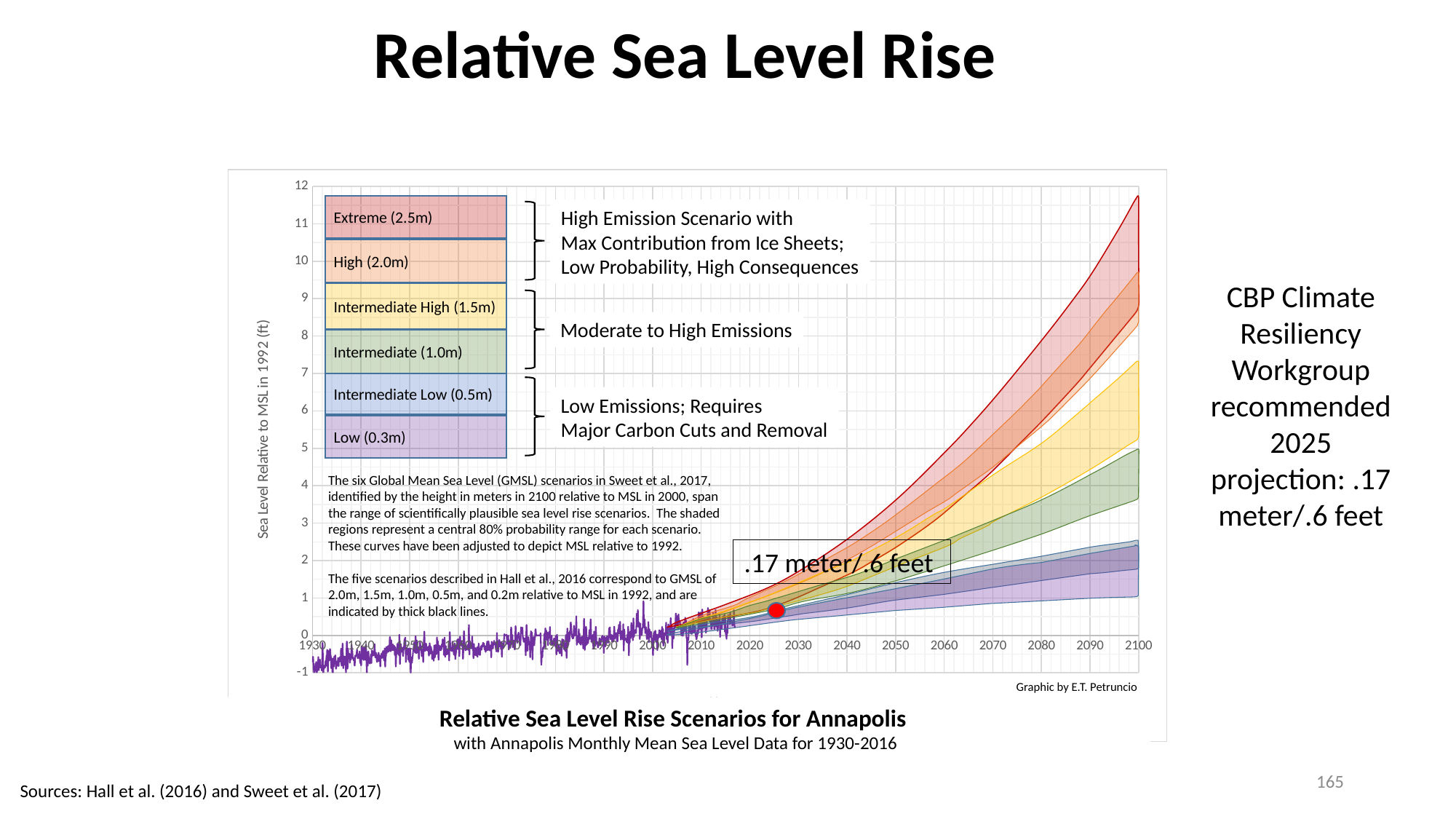
How many sea level rise scenarios does the chart's legend list? 6 Which scenario reaches the highest sea level by 2100 on the chart? Extreme (2.5m) Is the Low (0.3m) scenario band in 2100 greater or less than 3 feet? less Which scenario reaches the lowest sea level by 2100 on the chart? Low (0.3m) What is the title of the chart on the slide? Relative Sea Level Rise Scenarios for Annapolis What is the height in meters in 2100 associated with the High scenario in the legend? 2.0m Do the projected sea level scenarios rise or fall from 2020 to 2100? rise What kind of chart is shown on the slide? Line chart with shaded scenario bands Which scenario is higher in 2100, Intermediate High (1.5m) or Intermediate Low (0.5m)? Intermediate High (1.5m) What is the label of the chart's vertical axis? Sea Level Relative to MSL in 1992 (ft) What is the 2025 projection value marked on the chart? .17 meter/.6 feet Is the upper bound of the Extreme scenario in 2100 greater or less than 10 feet? greater